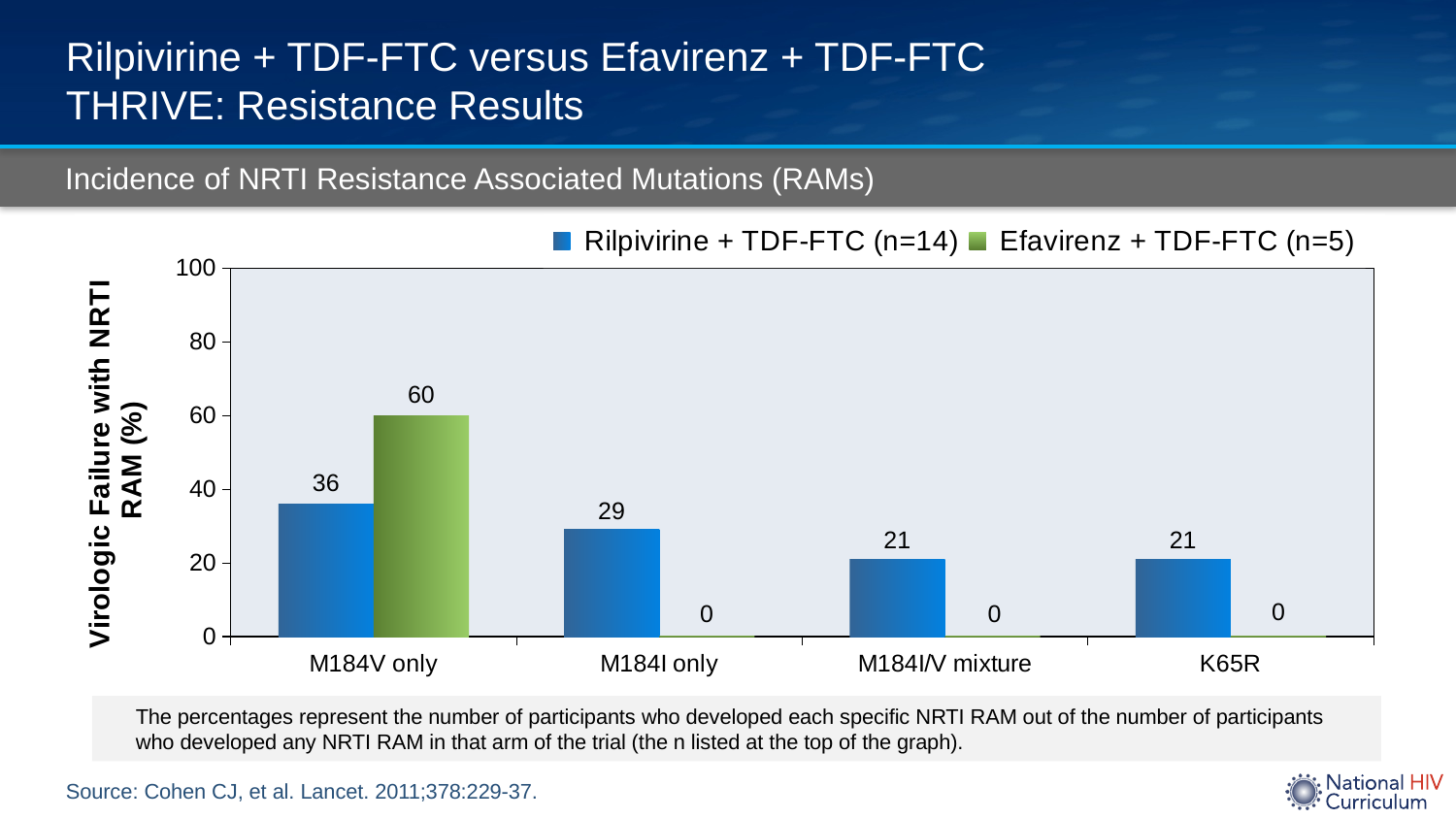
Which category has the highest value for Rilpivirine + TDF-FTC? M184V only What is the difference between the Efavirenz + TDF-FTC and Rilpivirine + TDF-FTC values in the M184V only category? 24 Which is larger in the M184V only category: Rilpivirine + TDF-FTC or Efavirenz + TDF-FTC? Efavirenz + TDF-FTC How many series does the legend list? 2 Do the Rilpivirine + TDF-FTC values rise or fall from M184V only to K65R along the x axis? Fall What kind of chart is shown on the slide? Bar chart What is the value for Efavirenz + TDF-FTC in the M184V only category? 60 What is the value for Rilpivirine + TDF-FTC in the M184I only category? 29 What is the label of the y axis? Virologic Failure with NRTI RAM (%) How many categories are shown on the x axis? 4 What is the value for Efavirenz + TDF-FTC in the K65R category? 0 What is the value for Rilpivirine + TDF-FTC in the M184V only category? 36